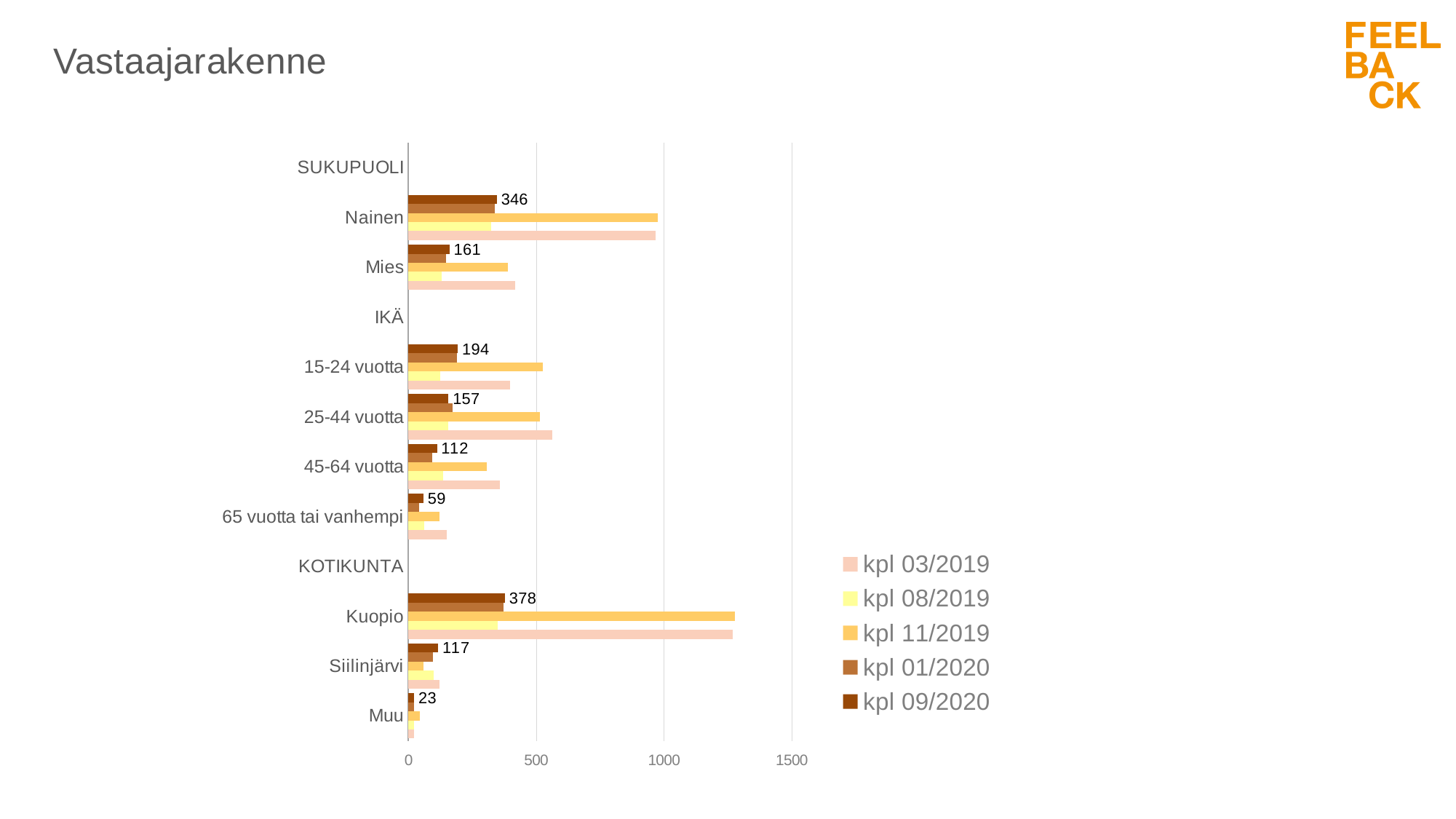
Among the age groups (IKÄ), which has the highest value in the kpl 09/2020 series? 15-24 vuotta In the kpl 09/2020 series, which is larger: 25-44 vuotta or 45-64 vuotta? 25-44 vuotta What is the value for Muu in the kpl 09/2020 series? 23 What is the value for Kuopio in the kpl 09/2020 series? 378 In the kpl 09/2020 series, what is the difference between Siilinjärvi and Muu? 94 Is the value for Kuopio in the kpl 11/2019 series greater or less than 1000? greater What is the value for 65 vuotta tai vanhempi in the kpl 09/2020 series? 59 What kind of chart is shown on the slide? bar chart What is the value for Nainen in the kpl 09/2020 series? 346 How many series does the legend list? 5 Among the KOTIKUNTA categories, which has the lowest value in the kpl 09/2020 series? Muu In the kpl 09/2020 series, what is the difference between Nainen and Mies? 185